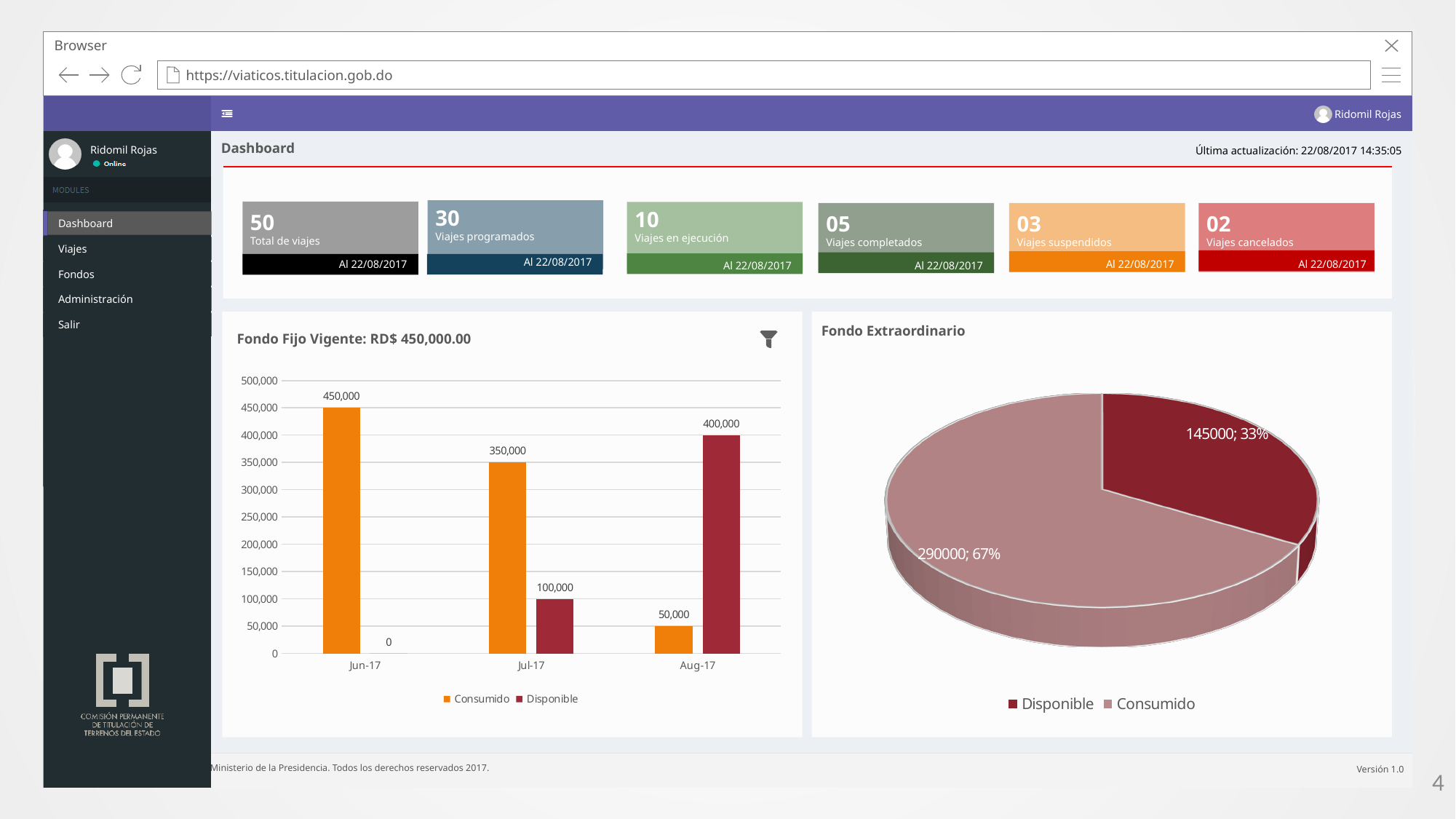
In the 'Fondo Fijo Vigente' bar chart, what is the difference between the Consumido and Disponible values for Jul-17? 250,000 In the 'Fondo Fijo Vigente' bar chart, what is the Consumido value for Jun-17? 450,000 In the 'Fondo Extraordinario' pie chart, what is the value of the Disponible slice? 145000 In the 'Fondo Fijo Vigente' bar chart, what is the Disponible value for Jul-17? 100,000 What kind of chart is the 'Fondo Extraordinario' chart? pie chart In the 'Fondo Fijo Vigente' bar chart, how many series does the legend list? 2 In the 'Fondo Fijo Vigente' bar chart, does the Consumido value rise or fall from Jun-17 to Aug-17? fall In the 'Fondo Fijo Vigente' bar chart, how many months are shown on the x axis? 3 In the 'Fondo Fijo Vigente' bar chart, what is the Disponible value for Aug-17? 400,000 In the 'Fondo Fijo Vigente' bar chart, which month has the lowest Consumido value? Aug-17 In the 'Fondo Extraordinario' pie chart, what share does Consumido have? 67% In the 'Fondo Fijo Vigente' bar chart, which is larger for Aug-17, Consumido or Disponible? Disponible